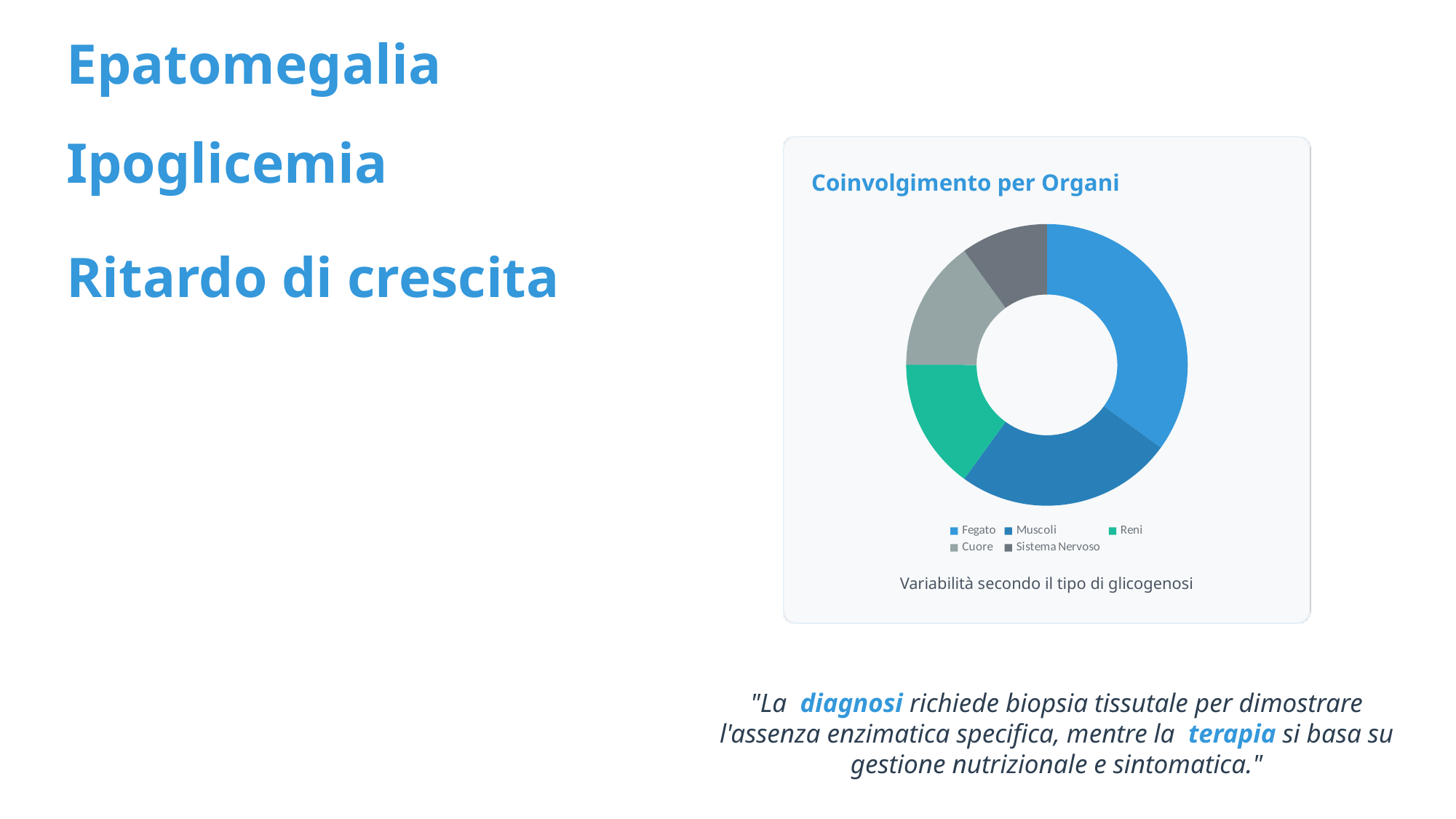
Which category has the largest slice in the "Coinvolgimento per Organi" chart? Fegato What kind of chart is shown under the title "Coinvolgimento per Organi"? Donut (pie) chart How many categories does the legend of the "Coinvolgimento per Organi" chart list? 5 What caption appears below the legend of the "Coinvolgimento per Organi" chart? Variabilità secondo il tipo di glicogenosi In the "Coinvolgimento per Organi" chart, which slice is larger, Fegato or Muscoli? Fegato In the "Coinvolgimento per Organi" chart, which slice is larger, Fegato or Sistema Nervoso? Fegato In the "Coinvolgimento per Organi" chart, which slice is larger, Cuore or Sistema Nervoso? Cuore What is the title of the chart on the slide? Coinvolgimento per Organi Which category has the smallest slice in the "Coinvolgimento per Organi" chart? Sistema Nervoso